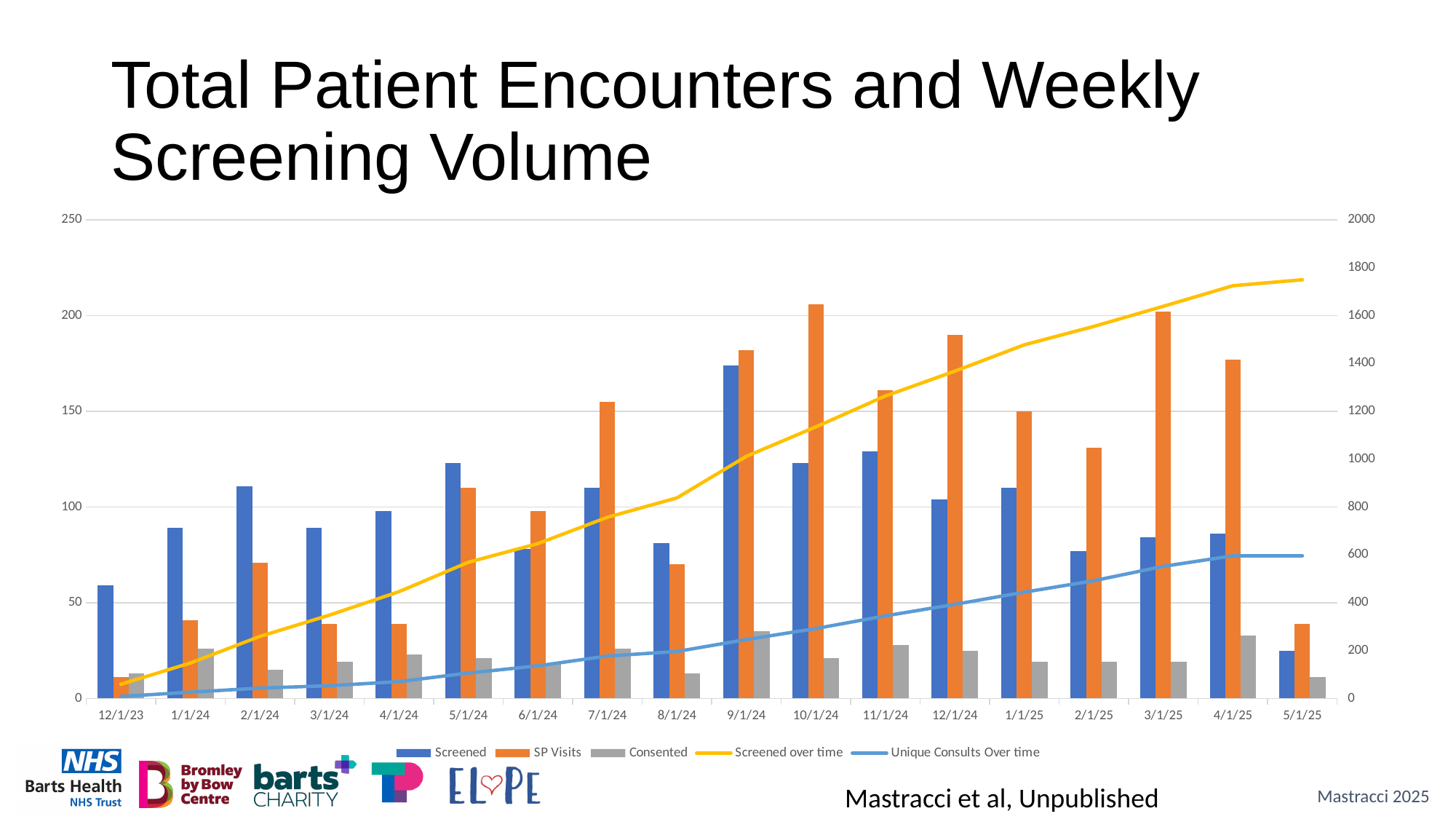
At which date is the Screened bar lowest? 5/1/25 Is the Consented value for 9/1/24 greater or less than 50 on the left axis? less Is the SP Visits value for 10/1/24 greater or less than 200 on the left axis? greater Is the Screened value for 12/1/23 greater or less than 50 on the left axis? greater At 3/1/25, which is larger: Screened or SP Visits? SP Visits How many dates are shown on the x axis? 18 At which date is the Screened bar highest? 9/1/24 How many series does the legend list? 5 At which date is the SP Visits bar highest? 10/1/24 Does the Screened over time line rise or fall from 12/1/23 to 5/1/25? rise At which date is the SP Visits bar lowest? 12/1/23